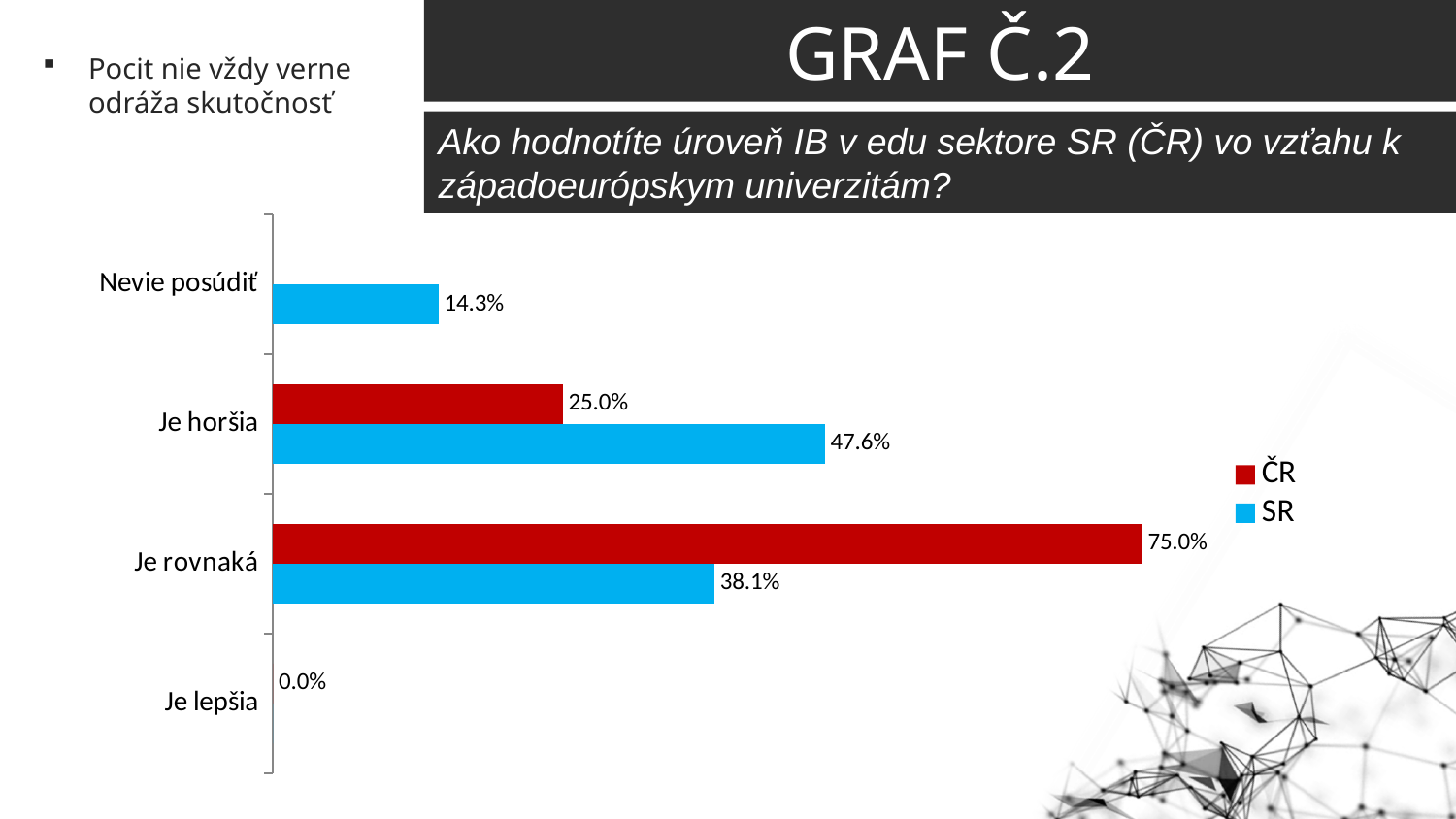
What is the difference between the ČR and SR values for 'Je rovnaká'? 36.9% What is the ČR value for 'Je rovnaká'? 75.0% How many series does the legend list? 2 What is the difference between the SR and ČR values for 'Je horšia'? 22.6% What is the SR value for 'Je rovnaká'? 38.1% Which category has the highest SR value? Je horšia What is the SR value for 'Nevie posúdiť'? 14.3% What kind of chart is shown on the slide? Bar chart For 'Je rovnaká', which series has the larger value, ČR or SR? ČR What is the ČR value for 'Je horšia'? 25.0% What is the SR value for 'Je horšia'? 47.6% Which category has the highest ČR value? Je rovnaká